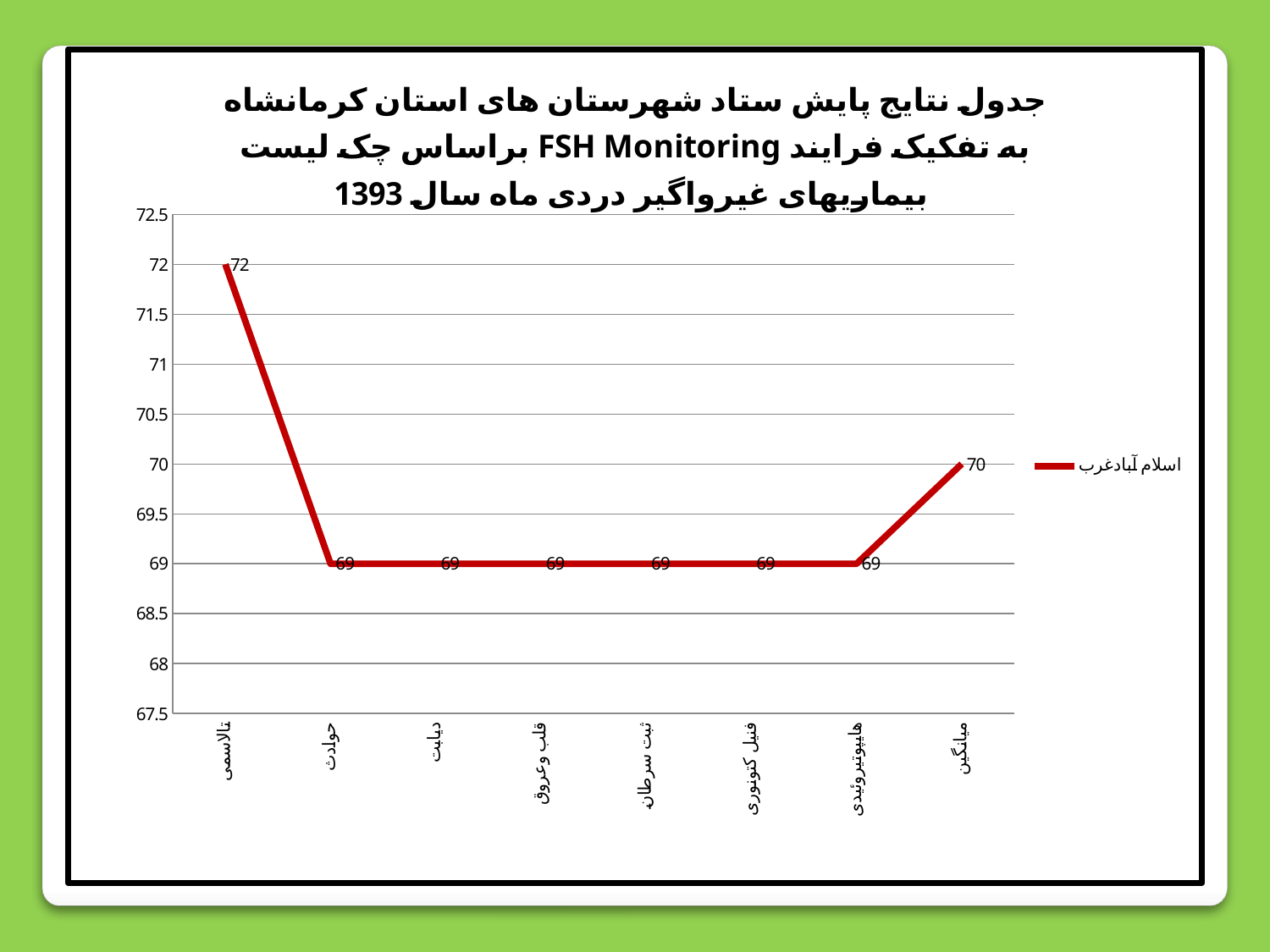
What is the value for میانگین? 70 Which category has the highest value? تالاسمی What is the difference between the values for تالاسمی and حوادث? 3 How many series does the legend list? 1 What is the value for دیابت? 69 Which is larger, the value for میانگین or the value for هایپوتیروئیدی? میانگین How many categories are shown on the x axis? 8 What is the name of the series shown in the legend? اسلام آبادغرب Is the value for تالاسمی greater or less than 71? greater What is the value for تالاسمی? 72 What is the difference between the values for تالاسمی and میانگین? 2 What type of chart is shown on the slide? line chart